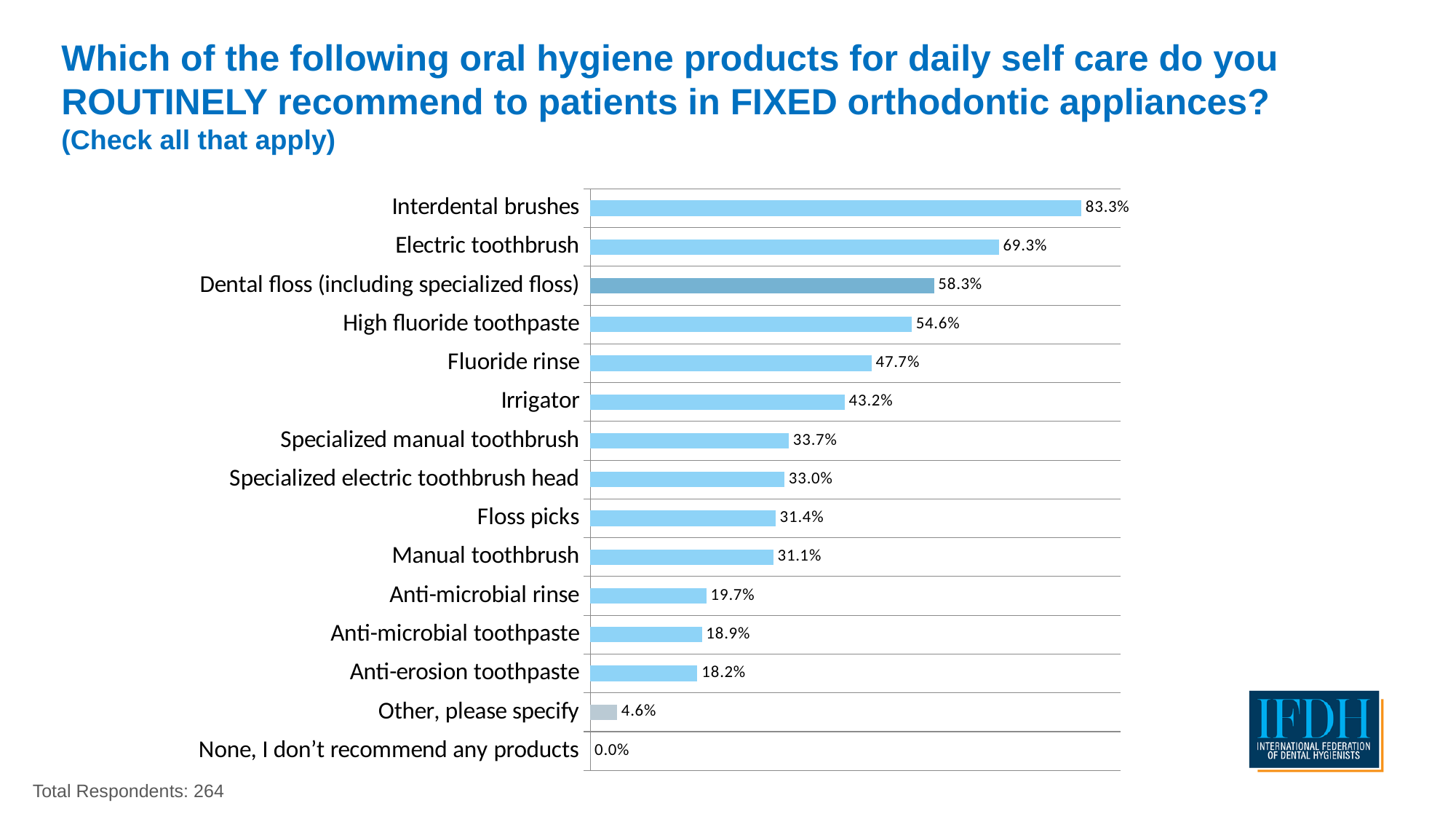
Which has a higher value: Irrigator or Specialized manual toothbrush? Irrigator Which product has the highest percentage of respondents recommending it? Interdental brushes What percentage is shown for Anti-erosion toothpaste? 18.2% How many total respondents are noted on the slide? 264 What type of chart is shown on the slide? Bar chart What percentage of respondents routinely recommend interdental brushes? 83.3% Which bar is drawn in a darker blue than the others? Dental floss (including specialized floss) What is the difference in percentage points between Electric toothbrush and Dental floss (including specialized floss)? 11.0 How many categories are shown on the chart? 15 What is the value shown for Other, please specify? 4.6% Which category has the lowest value on the chart? None, I don't recommend any products What is the value shown for Fluoride rinse? 47.7%